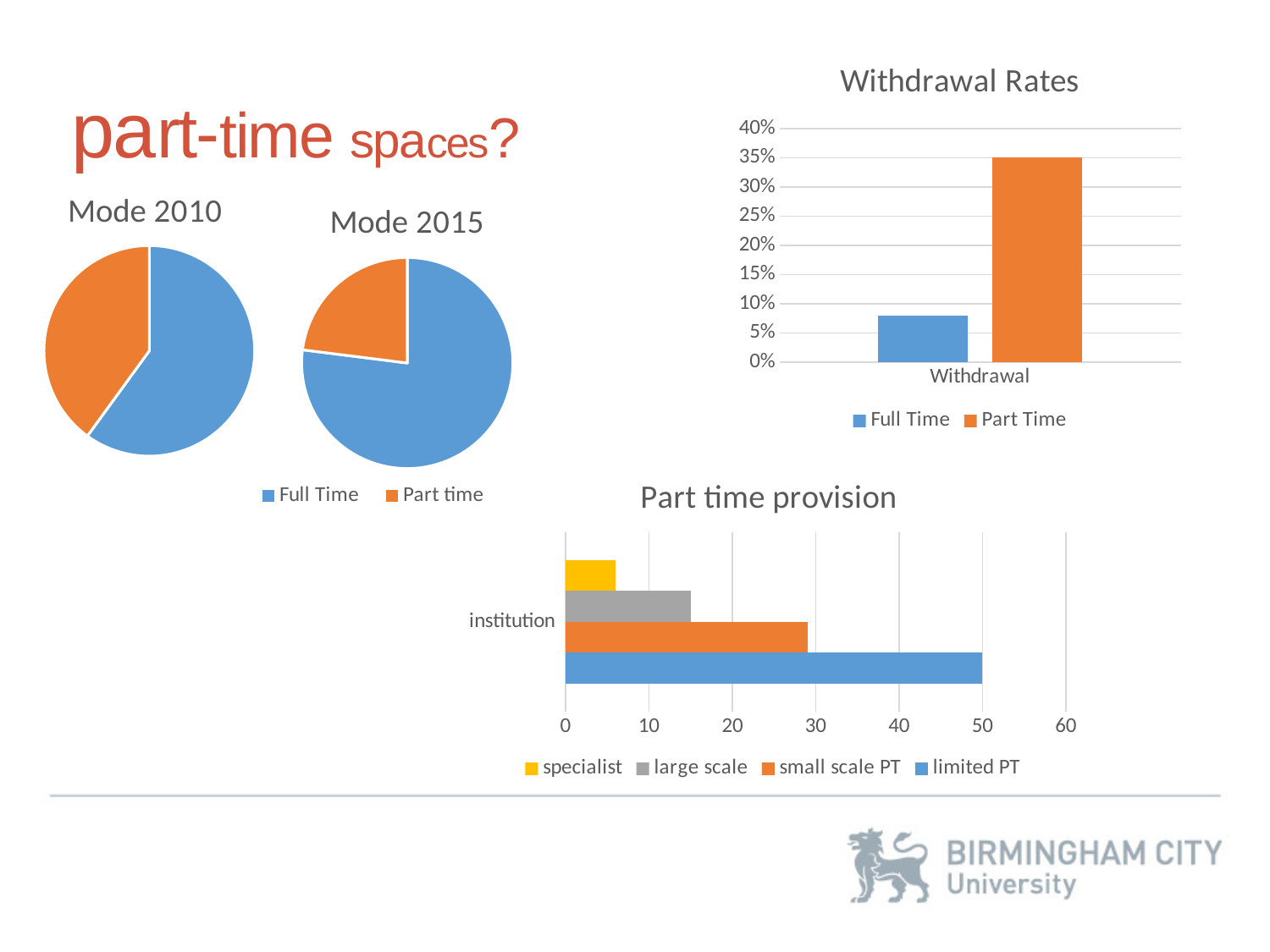
Which pie chart has the larger Part time slice, Mode 2010 or Mode 2015? Mode 2010 In the Mode 2010 pie chart, which slice is larger, Full Time or Part time? Full Time In the Part time provision chart, which series has the highest value? limited PT In the Part time provision chart, is the value for small scale PT greater or less than 20? greater In the Withdrawal Rates chart, is the Full Time withdrawal rate greater or less than 10%? less How many series does the legend of the Part time provision chart list? 4 What kind of chart is the Part time provision chart? bar chart What kind of chart is the Withdrawal Rates chart? bar chart In the Withdrawal Rates chart, is the Part Time withdrawal rate greater or less than 30%? greater In the Withdrawal Rates chart, which series has the higher withdrawal rate, Full Time or Part Time? Part Time How many series does the legend of the Withdrawal Rates chart list? 2 What kind of chart is the Mode 2010 chart? pie chart